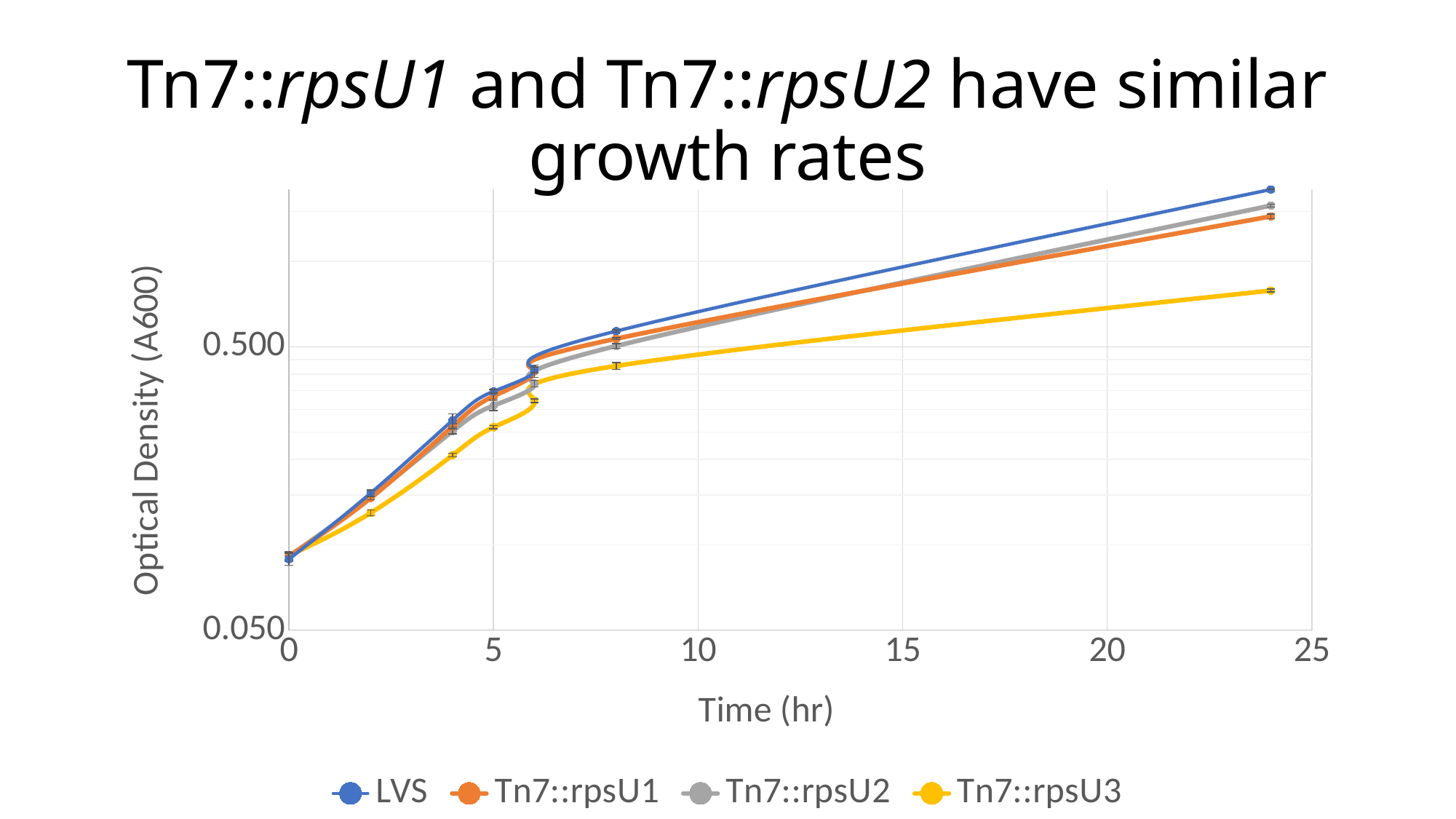
How many time points are plotted for each series? 7 Is the optical density of Tn7::rpsU3 at 24 hours greater or less than 0.500? greater Which series has the lowest optical density at 24 hours? Tn7::rpsU3 What is the label of the x axis? Time (hr) Is the optical density of Tn7::rpsU3 at 8 hours greater or less than 0.500? less At 24 hours, which is larger, the optical density of LVS or of Tn7::rpsU3? LVS Which series has the highest optical density at 24 hours? LVS Do the optical density values rise or fall as time increases? rise Is the optical density of LVS at 24 hours greater or less than 0.500? greater What kind of chart is shown on the slide? line chart How many series does the legend list? 4